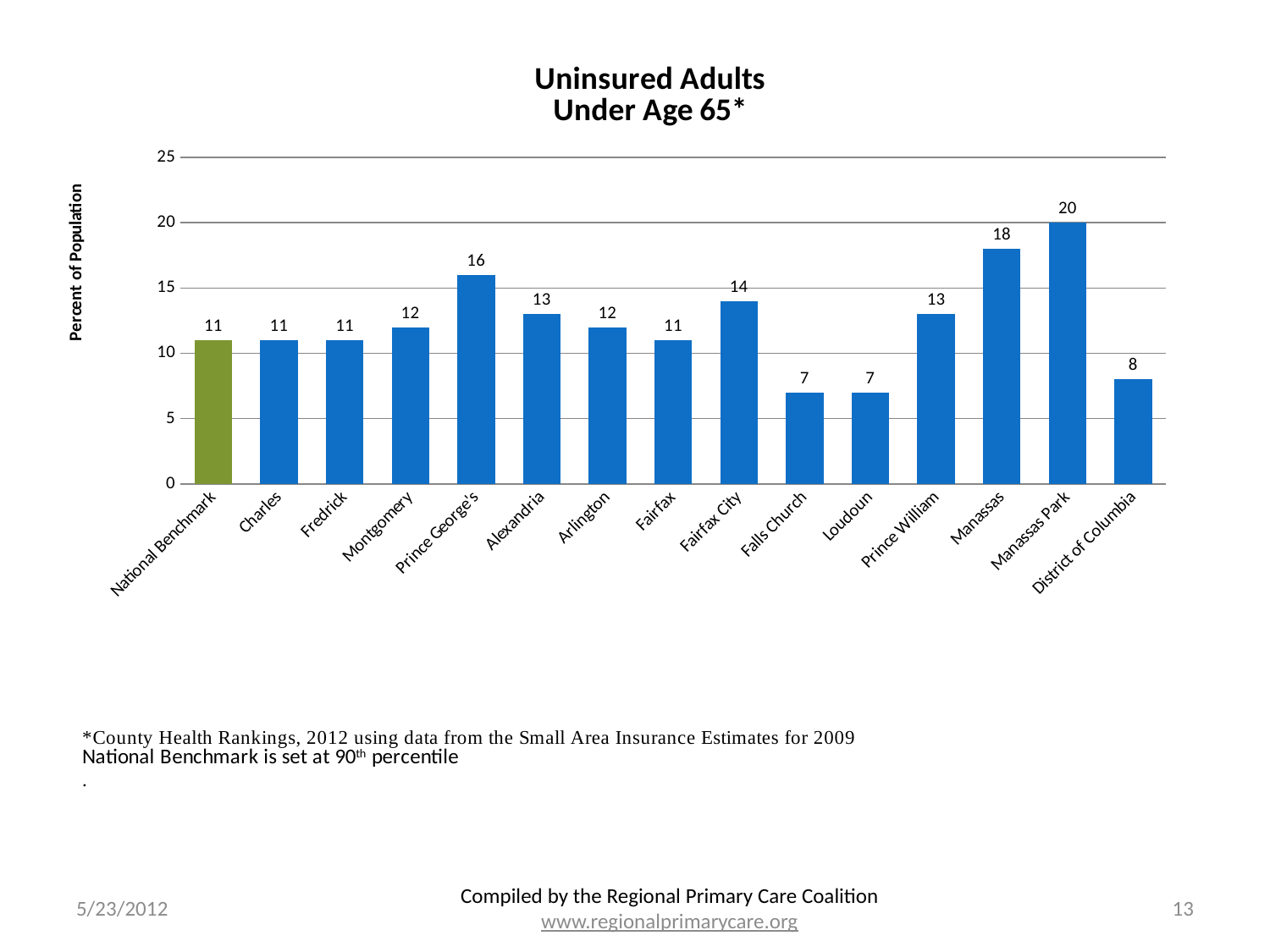
What is the title of the chart? Uninsured Adults Under Age 65* Is the value for Manassas greater or less than 15? greater How many categories are shown on the x axis? 15 What is the label of the y axis? Percent of Population Which is larger, the value for Fairfax City or the value for Arlington? Fairfax City What is the value for Manassas Park? 20 Which category has the highest value? Manassas Park What is the value for the National Benchmark? 11 What is the value for Prince George's? 16 What kind of chart is shown on the slide? bar chart What is the value for District of Columbia? 8 What is the difference between the values for Manassas and Alexandria? 5